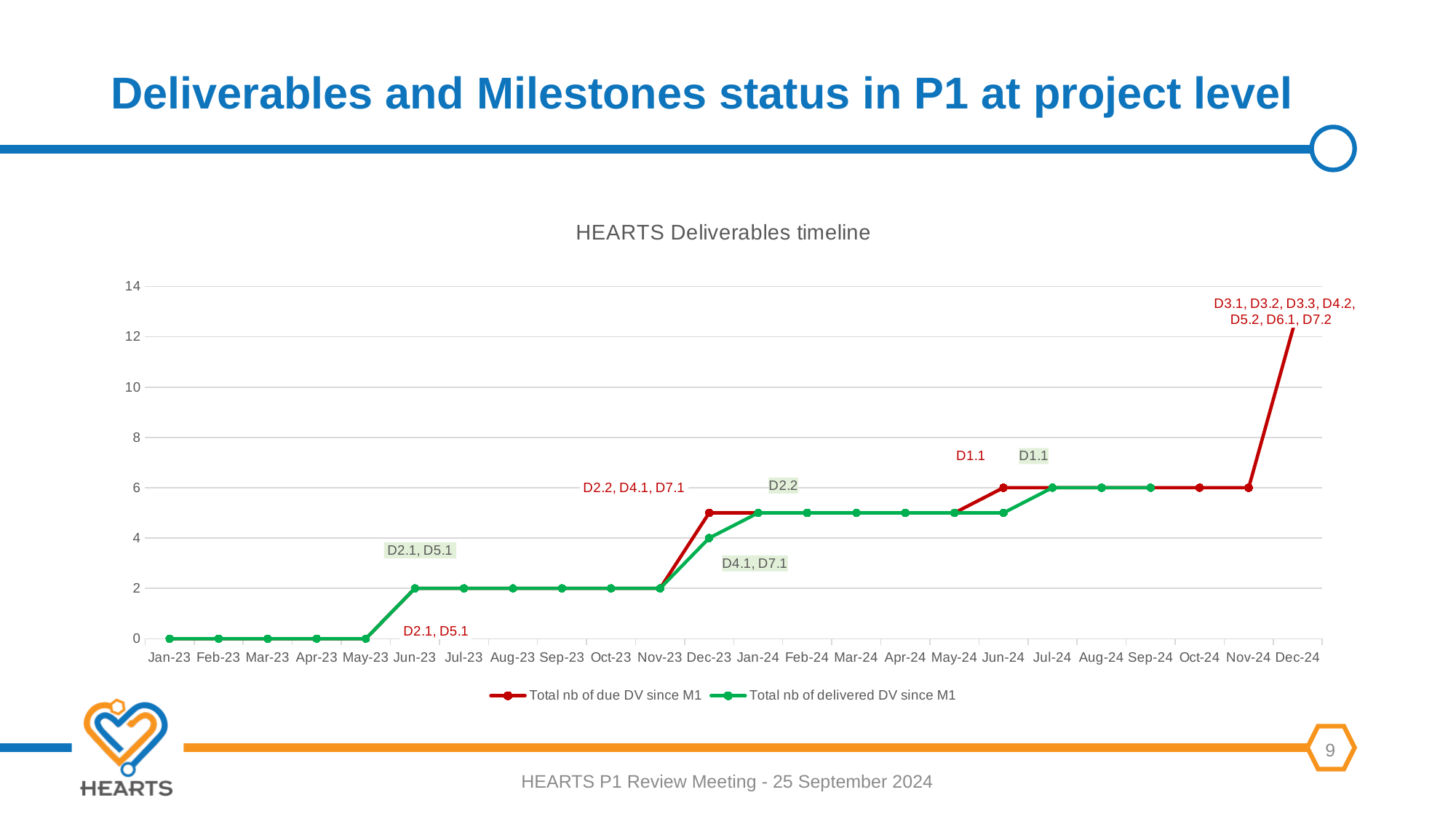
What is the value of 'Total nb of delivered DV since M1' at Oct-23? 2 How many series does the legend list? 2 Is the value of 'Total nb of delivered DV since M1' at Feb-24 greater or less than 4? greater What is the title of the chart? HEARTS Deliverables timeline What is the value of 'Total nb of delivered DV since M1' at Jun-23? 2 In which month does 'Total nb of due DV since M1' reach its highest value? Dec-24 Does the 'Total nb of due DV since M1' line rise or fall from Jan-23 to Dec-24? rise Is the value of 'Total nb of due DV since M1' at Dec-24 greater or less than 10? greater What is the value of 'Total nb of due DV since M1' at Jun-24? 6 At Jun-24, which series has the higher value? Total nb of due DV since M1 How many months are shown on the x axis? 24 What kind of chart is shown on the slide? line chart